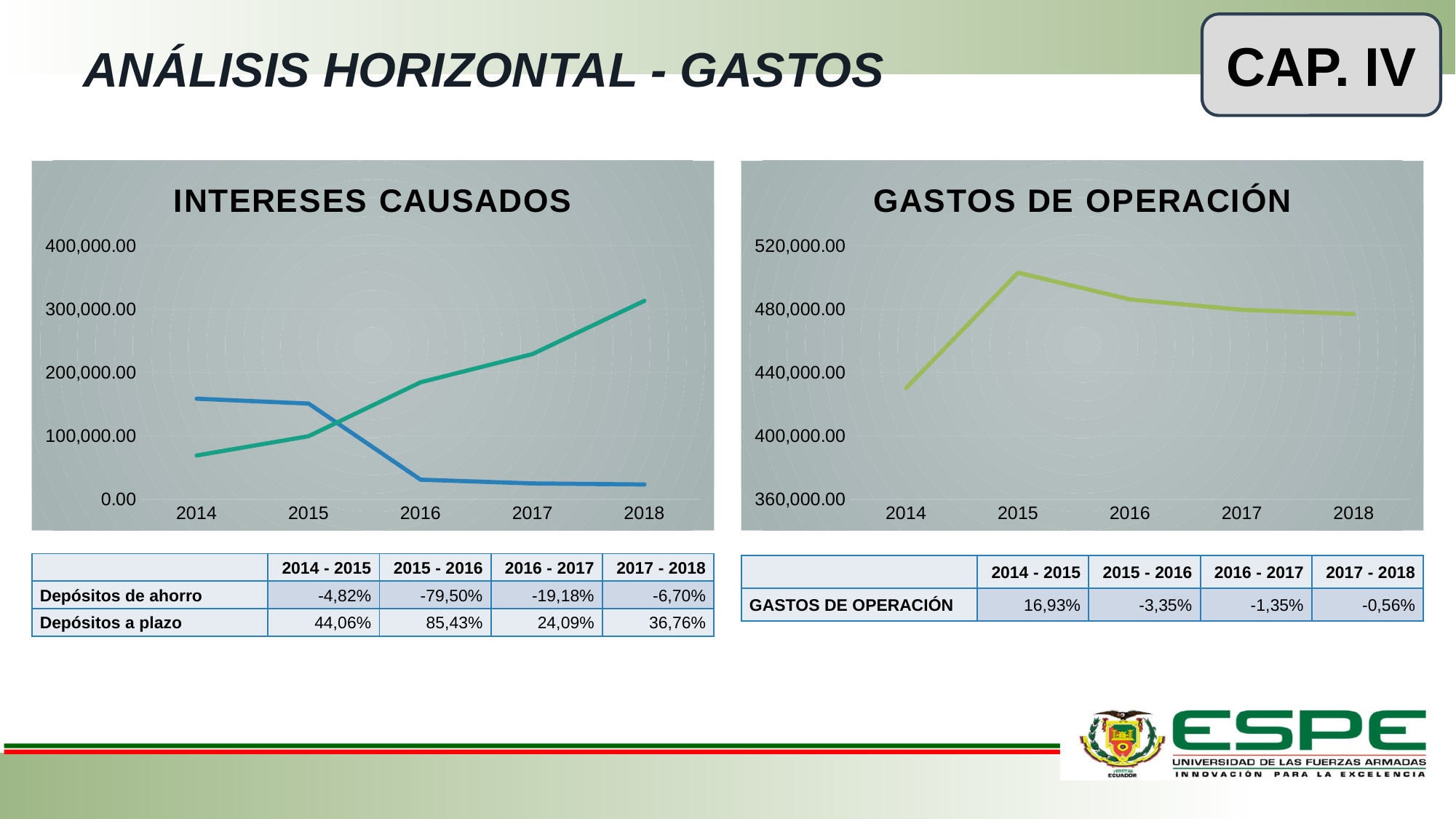
In the INTERESES CAUSADOS chart, does the green line rise or fall from 2014 to 2018? rise In the GASTOS DE OPERACIÓN chart, is the value for 2014 greater or less than 440,000.00? less In the GASTOS DE OPERACIÓN chart, do the values rise or fall from 2015 to 2018? fall In the INTERESES CAUSADOS chart, is the green line's value for 2018 greater or less than 300,000.00? greater In the INTERESES CAUSADOS chart, in which year does the blue line reach its lowest value? 2018 In the INTERESES CAUSADOS chart, which line is higher in 2014, the blue line or the green line? the blue line In the GASTOS DE OPERACIÓN chart, which year has the highest value? 2015 In the GASTOS DE OPERACIÓN chart, which year has the lowest value? 2014 What kind of chart is the GASTOS DE OPERACIÓN chart? line chart What kind of chart is the INTERESES CAUSADOS chart? line chart In the GASTOS DE OPERACIÓN chart, how many years are shown on the x axis? 5 In the GASTOS DE OPERACIÓN chart, is the value for 2015 greater or less than 480,000.00? greater